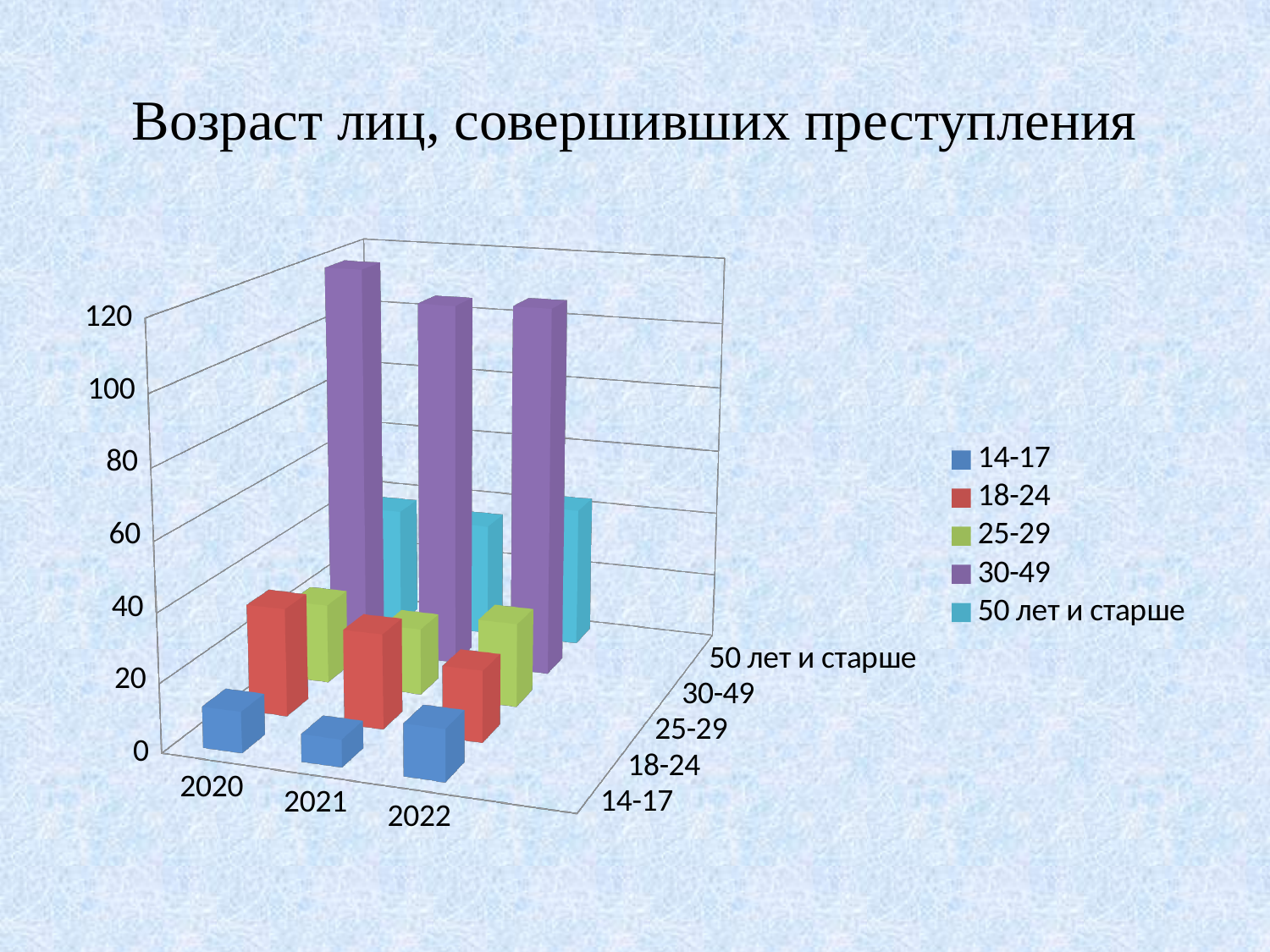
Which age group has the lowest bars across all years? 14-17 What kind of chart is shown on the slide? bar chart Is the value for the 30-49 group in 2020 greater or less than 80? greater What is the title of the chart? Возраст лиц, совершивших преступления How many series does the legend list? 5 Which is larger in 2020: the value for 30-49 or the value for 14-17? 30-49 How many years are shown along the x axis? 3 Which is larger in 2022: the value for 30-49 or the value for 25-29? 30-49 What colour represents the 30-49 series in the legend? purple Is the value for the 50 лет и старше group in 2022 greater or less than 100? less Which age group has the highest bars across all years? 30-49 Is the value for the 14-17 group in 2020 greater or less than 40? less